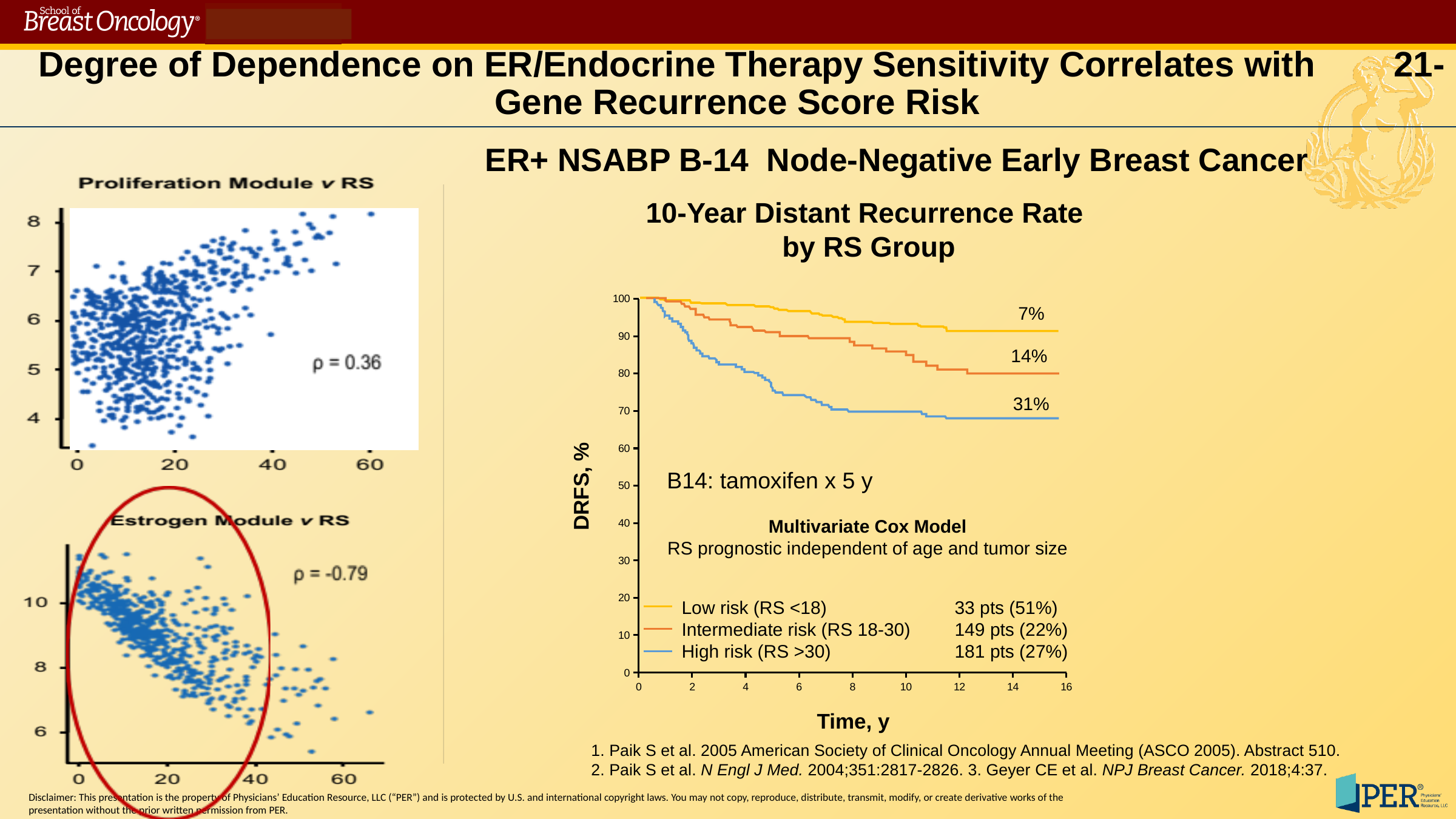
On the 'Proliferation Module v RS' scatter plot, what correlation coefficient is printed? ρ = 0.36 On the '10-Year Distant Recurrence Rate by RS Group' chart, is the DRFS value of the low risk curve at the end of follow-up greater or less than 90? greater On the '10-Year Distant Recurrence Rate by RS Group' chart, what is the label of the y axis? DRFS, % On the '10-Year Distant Recurrence Rate by RS Group' chart, which RS group has the highest 10-year distant recurrence rate? High risk (RS >30) On the 'Estrogen Module v RS' scatter plot, do the values rise or fall as RS increases along the x axis? fall On the '10-Year Distant Recurrence Rate by RS Group' chart, what is the difference between the high risk and low risk 10-year distant recurrence rates? 24% On the '10-Year Distant Recurrence Rate by RS Group' chart, what is the 10-year distant recurrence rate labelled for the intermediate risk (RS 18-30) group? 14% On the '10-Year Distant Recurrence Rate by RS Group' chart, is the DRFS value of the high risk curve at the end of follow-up greater or less than 70? less On the '10-Year Distant Recurrence Rate by RS Group' chart, what is the 10-year distant recurrence rate labelled for the low risk (RS <18) group? 7% On the '10-Year Distant Recurrence Rate by RS Group' chart, how many series does the legend list? 3 On the '10-Year Distant Recurrence Rate by RS Group' chart, what is the 10-year distant recurrence rate labelled for the high risk (RS >30) group? 31% On the '10-Year Distant Recurrence Rate by RS Group' chart, how many patients are in the intermediate risk (RS 18-30) group according to the legend? 149 pts (22%)